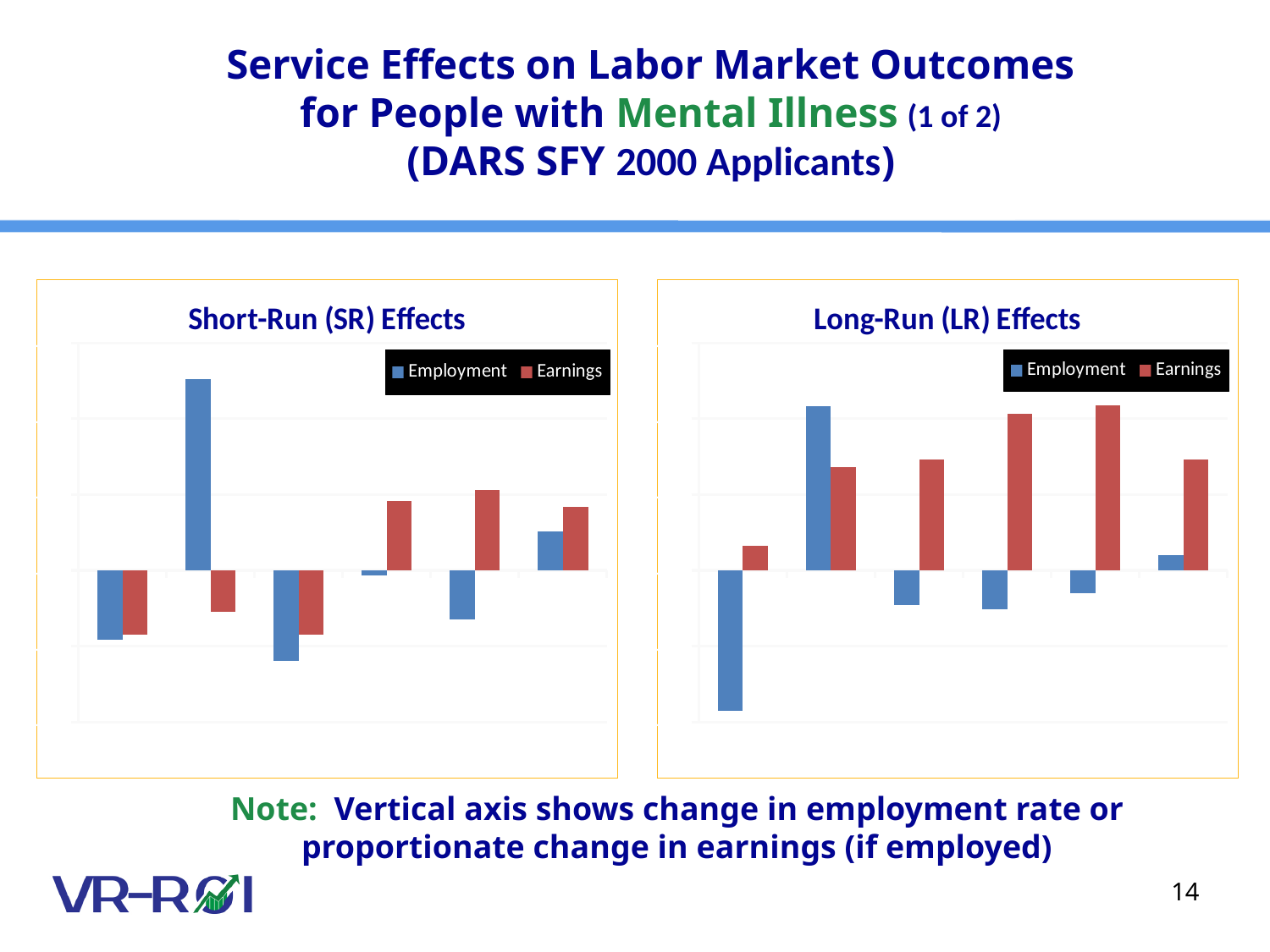
In the Long-Run (LR) Effects chart, which series contains the bar that extends furthest below the horizontal axis? Employment In the Long-Run (LR) Effects chart, how many Earnings bars are negative (below the horizontal axis)? 0 In the Short-Run (SR) Effects chart, how many Earnings bars are positive (above the horizontal axis)? 3 What kind of chart is the Short-Run (SR) Effects chart? bar chart What kind of chart is the Long-Run (LR) Effects chart? bar chart In the Long-Run (LR) Effects chart, how many Employment bars are negative (below the horizontal axis)? 4 How many series does the legend of the Long-Run (LR) Effects chart list? 2 What is the title of the chart on the right side of the slide? Long-Run (LR) Effects How many series does the legend of the Short-Run (SR) Effects chart list? 2 What colour represents the Earnings series in both charts? red